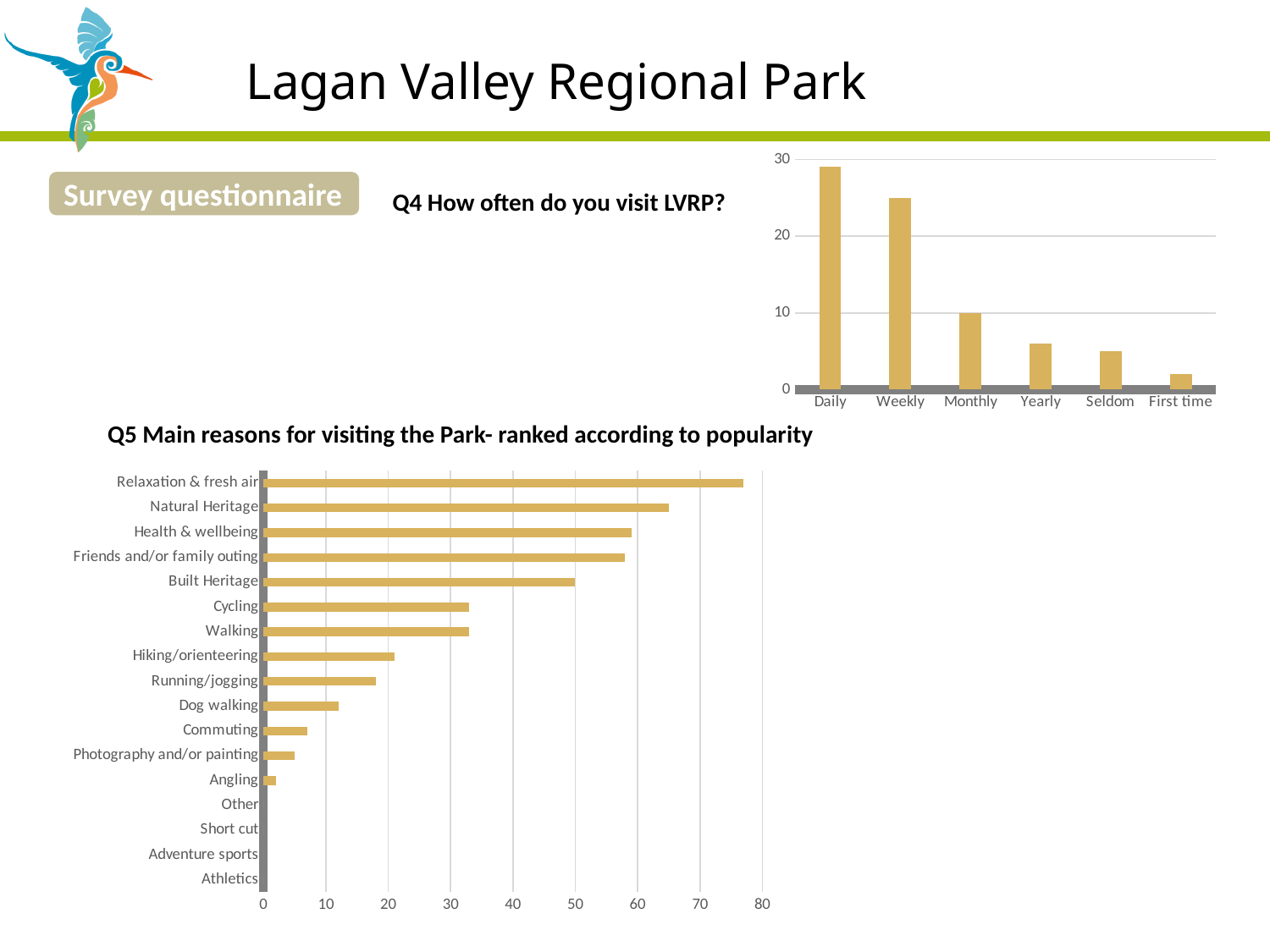
In the Q5 chart (Main reasons for visiting the Park), is the value for Dog walking greater or less than 20? less In the Q4 chart (How often do you visit LVRP?), which visit frequency has the highest bar? Daily In the Q4 chart (How often do you visit LVRP?), is the value for Daily greater or less than 20? greater What type of chart is the Q5 chart (Main reasons for visiting the Park)? Bar chart In the Q5 chart (Main reasons for visiting the Park), how many reasons are listed on the vertical axis? 17 In the Q4 chart (How often do you visit LVRP?), do the values rise or fall from Daily to First time? fall In the Q4 chart (How often do you visit LVRP?), how many visit-frequency categories are shown? 6 In the Q4 chart (How often do you visit LVRP?), is the value for Yearly greater or less than 10? less In the Q5 chart (Main reasons for visiting the Park), which is larger, Hiking/orienteering or Commuting? Hiking/orienteering In the Q5 chart (Main reasons for visiting the Park), which reason has the longest bar? Relaxation & fresh air In the Q4 chart (How often do you visit LVRP?), which visit frequency has the lowest bar? First time